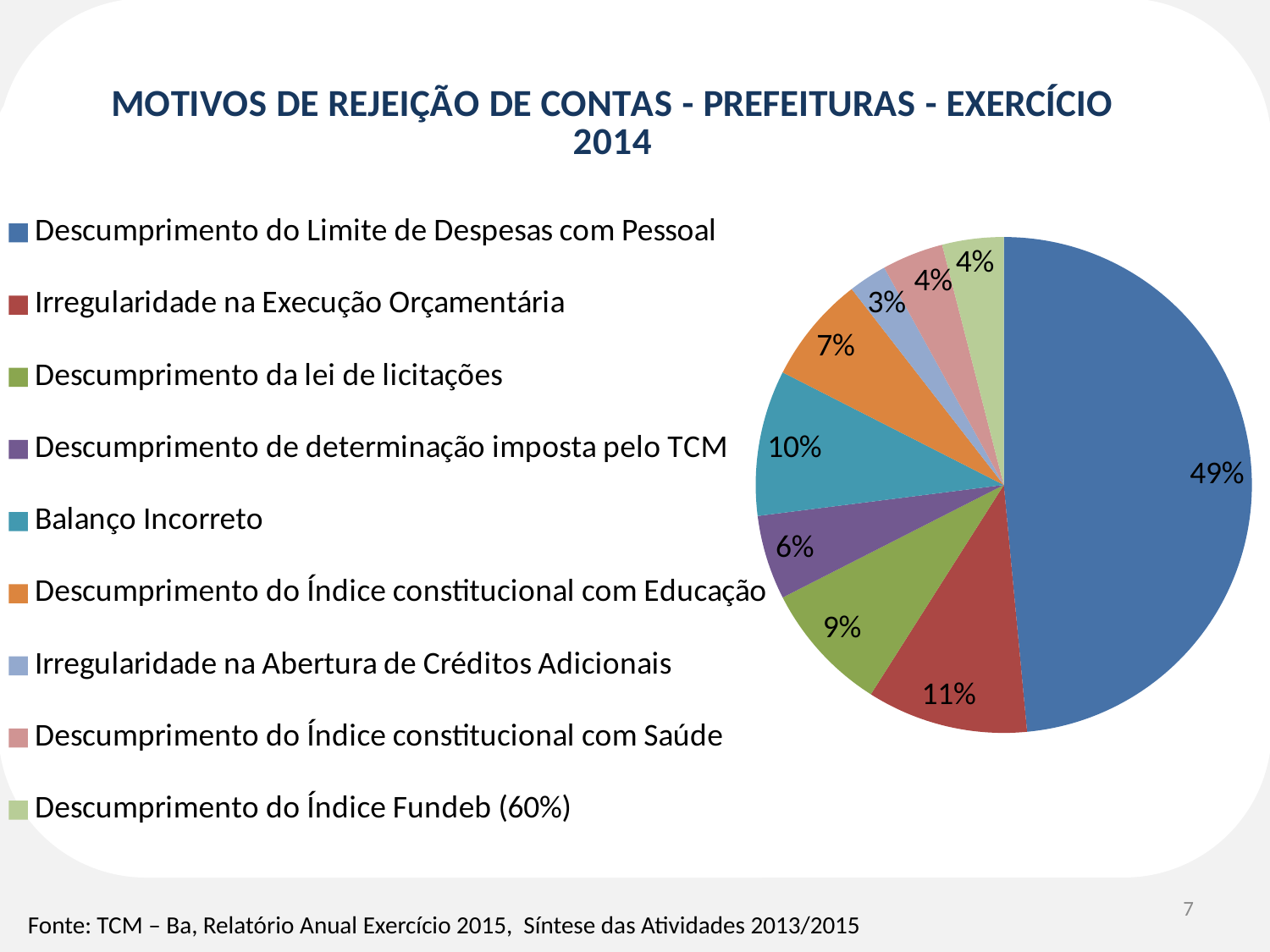
What kind of chart is shown on the slide? Pie chart What is the value shown for "Descumprimento da lei de licitações"? 9% Which category has the largest slice of the pie? Descumprimento do Limite de Despesas com Pessoal What is the difference between the shares of "Irregularidade na Execução Orçamentária" and "Descumprimento de determinação imposta pelo TCM"? 5% What is the value shown for "Irregularidade na Abertura de Créditos Adicionais"? 3% What is the value shown for "Balanço Incorreto"? 10% What share of the pie does "Descumprimento do Limite de Despesas com Pessoal" represent? 49% What is the value shown for "Irregularidade na Execução Orçamentária"? 11% Which is larger: the share for "Balanço Incorreto" or the share for "Descumprimento do Índice constitucional com Educação"? Balanço Incorreto What is the title of the chart on the slide? MOTIVOS DE REJEIÇÃO DE CONTAS - PREFEITURAS - EXERCÍCIO 2014 Which category has the smallest slice of the pie? Irregularidade na Abertura de Créditos Adicionais How many categories does the pie chart have? 9